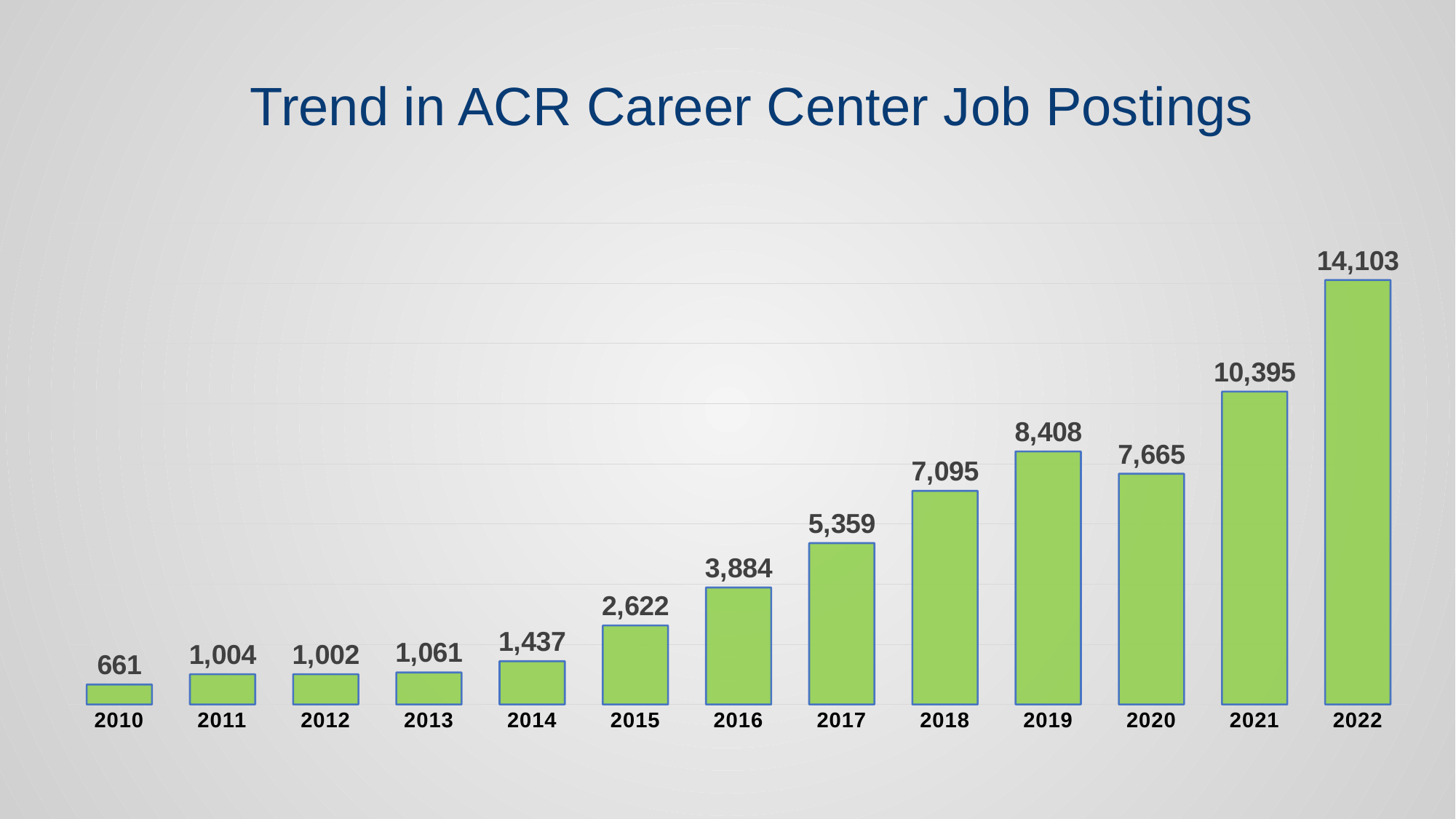
What is the title of the chart? Trend in ACR Career Center Job Postings How many years are shown on the chart? 13 Which year has the lowest number of job postings? 2010 What is the number of job postings in 2020? 7,665 Which year had more job postings, 2019 or 2020? 2019 What is the difference in job postings between 2022 and 2021? 3,708 Which year had more job postings, 2011 or 2012? 2011 What is the difference in job postings between 2019 and 2020? 743 What is the number of job postings in 2016? 3,884 Which year has the highest number of job postings? 2022 What kind of chart is shown on the slide? Bar chart What is the number of job postings in 2010? 661